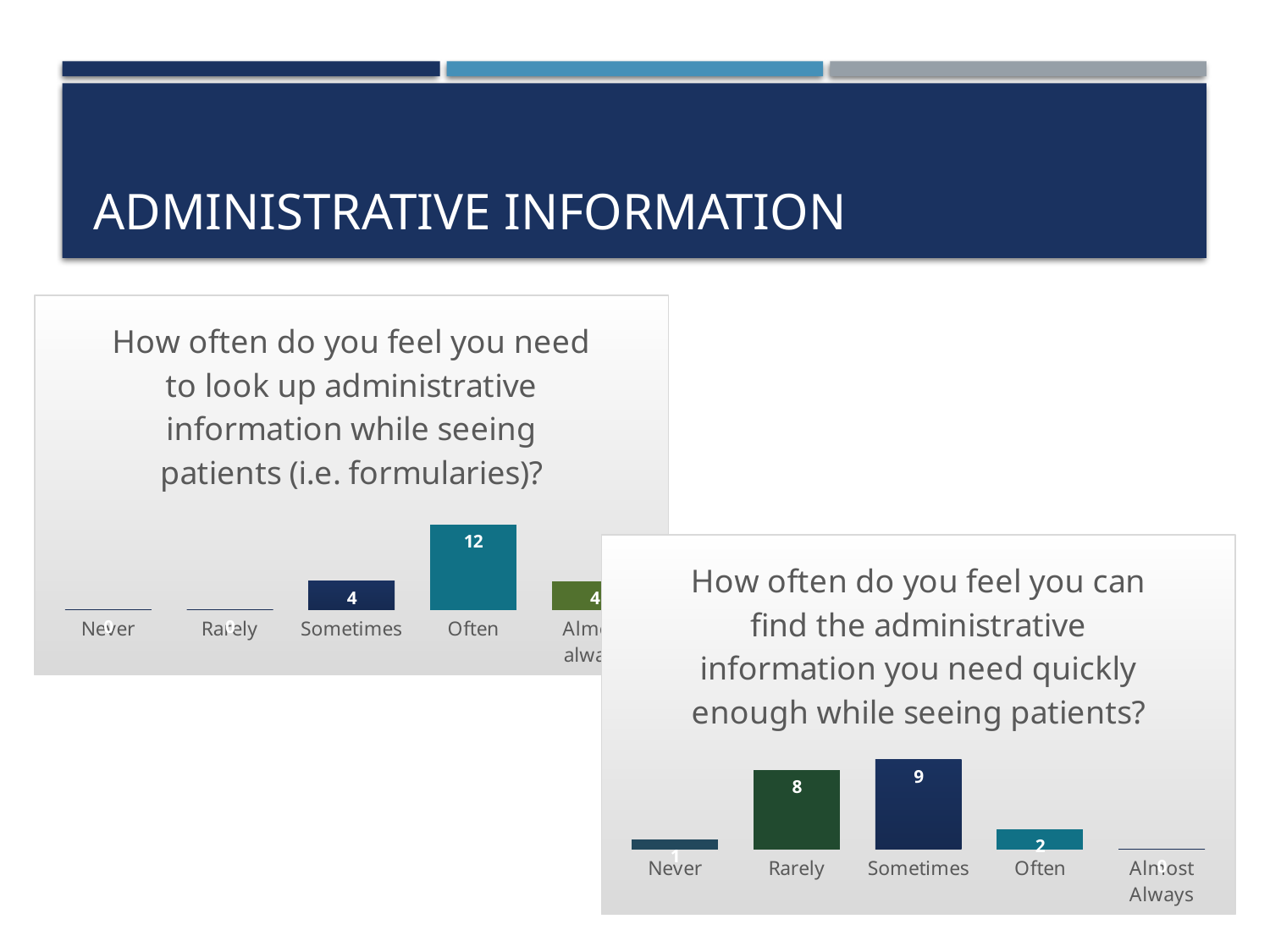
In the chart titled "How often do you feel you can find the administrative information you need quickly enough while seeing patients?", what is the value for Sometimes? 9 In the chart titled "How often do you feel you need to look up administrative information while seeing patients (i.e. formularies)?", what is the value for Often? 12 In the chart titled "How often do you feel you can find the administrative information you need quickly enough while seeing patients?", how many categories are shown on the x axis? 5 What kind of chart is the one titled "How often do you feel you can find the administrative information you need quickly enough while seeing patients?"? Bar chart In the chart titled "How often do you feel you can find the administrative information you need quickly enough while seeing patients?", what is the value for Often? 2 In the chart titled "How often do you feel you need to look up administrative information while seeing patients (i.e. formularies)?", what is the value for Never? 0 In the chart titled "How often do you feel you can find the administrative information you need quickly enough while seeing patients?", which is larger, the value for Rarely or the value for Often? Rarely In the chart titled "How often do you feel you can find the administrative information you need quickly enough while seeing patients?", what is the value for Rarely? 8 In the chart titled "How often do you feel you need to look up administrative information while seeing patients (i.e. formularies)?", what is the difference between the values for Often and Sometimes? 8 In the chart titled "How often do you feel you need to look up administrative information while seeing patients (i.e. formularies)?", which category has the highest value? Often In the chart titled "How often do you feel you need to look up administrative information while seeing patients (i.e. formularies)?", what is the value for Sometimes? 4 In the chart titled "How often do you feel you can find the administrative information you need quickly enough while seeing patients?", which category has the highest value? Sometimes